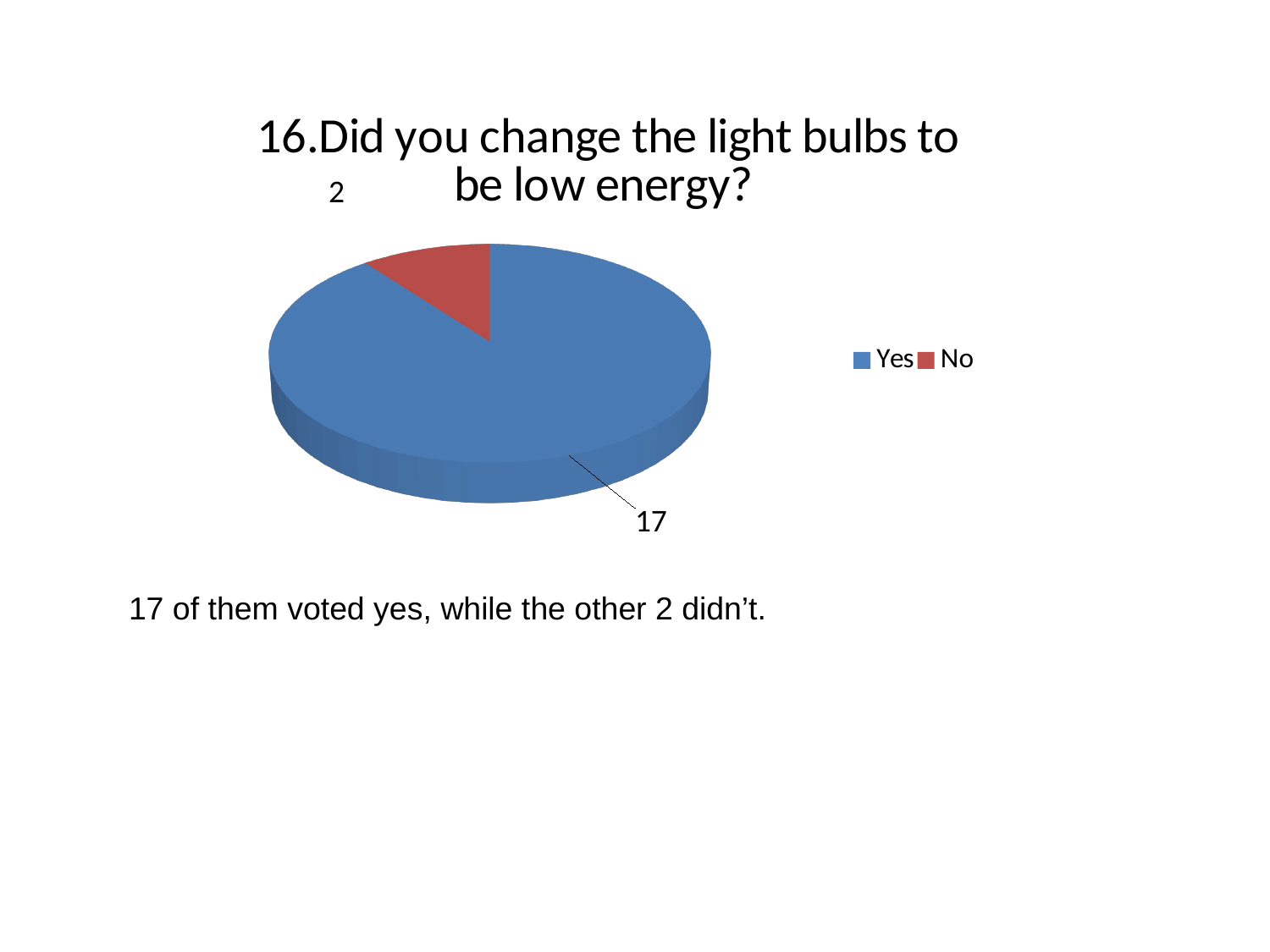
What is the value for No? 2 What is the value for Yes? 17 How many entries does the legend list? 2 What colour is the Yes slice? blue Which category has the largest slice? Yes Which category has the smallest slice? No What is the total of all slices in the pie chart? 19 How many slices does the pie chart have? 2 Which is larger, the value for Yes or the value for No? Yes What kind of chart is shown on the slide? pie chart What is the title of the chart? 16.Did you change the light bulbs to be low energy? What is the difference between the Yes and No values? 15